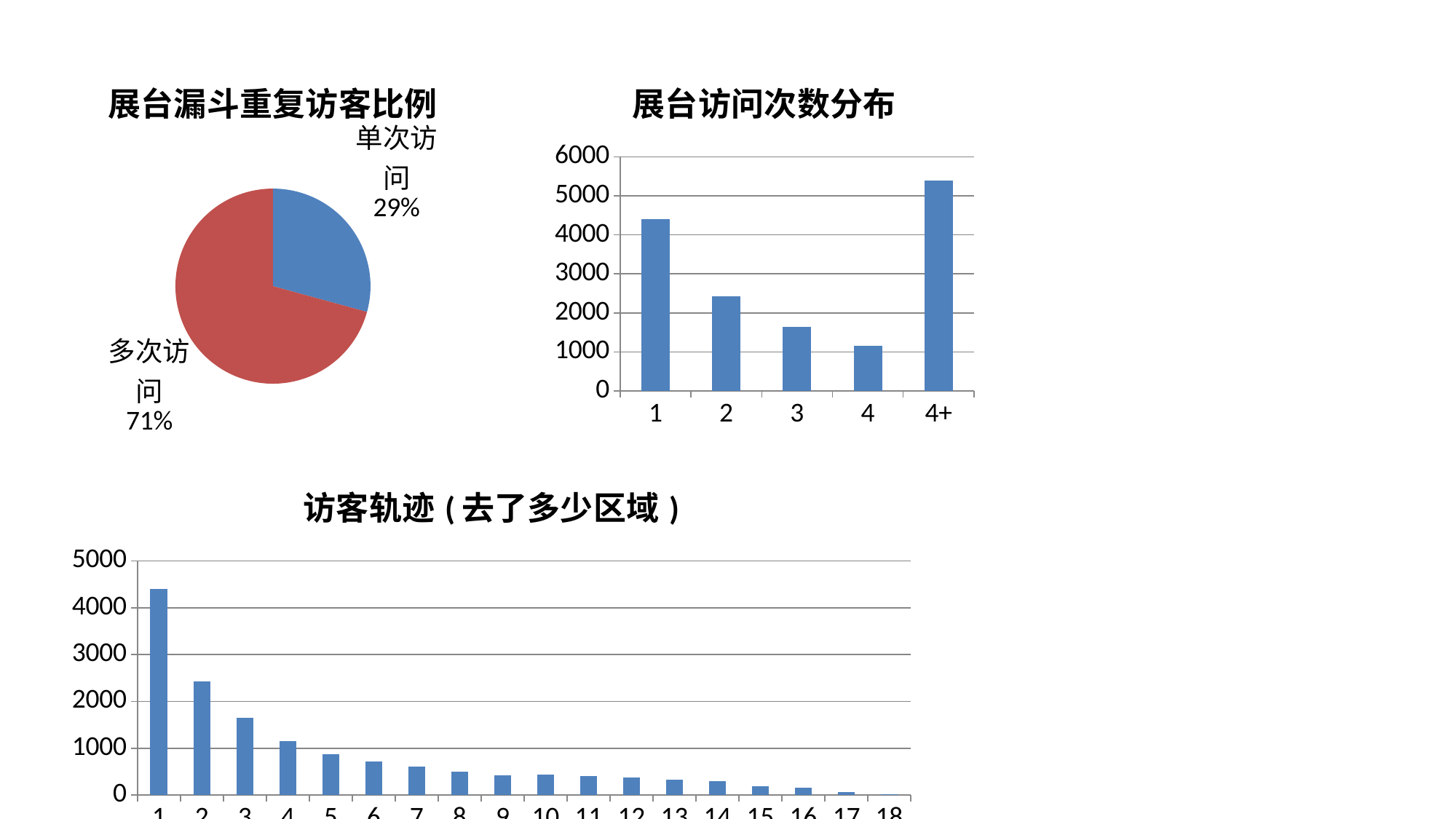
In the chart titled 展台访问次数分布, is the value for category 1 greater or less than 4000? greater In the chart titled 展台访问次数分布, which category has the lowest value? 4 What kind of chart is the one titled 展台访问次数分布? bar chart In the chart titled 展台漏斗重复访客比例, what percentage is shown for 多次访问? 71% How many categories are shown on the x axis of the chart titled 展台访问次数分布? 5 In the chart titled 展台访问次数分布, which category has the highest value? 4+ In the chart titled 展台访问次数分布, is the value for category 3 greater or less than 2000? less In the chart titled 展台漏斗重复访客比例, what percentage is shown for 单次访问? 29% In the chart titled 展台漏斗重复访客比例, which slice is larger, 单次访问 or 多次访问? 多次访问 In the chart titled 访客轨迹（去了多少区域）, do the values generally rise or fall from category 1 to category 18? fall What kind of chart is the one titled 展台漏斗重复访客比例? pie chart In the chart titled 访客轨迹（去了多少区域）, which category has the highest value? 1